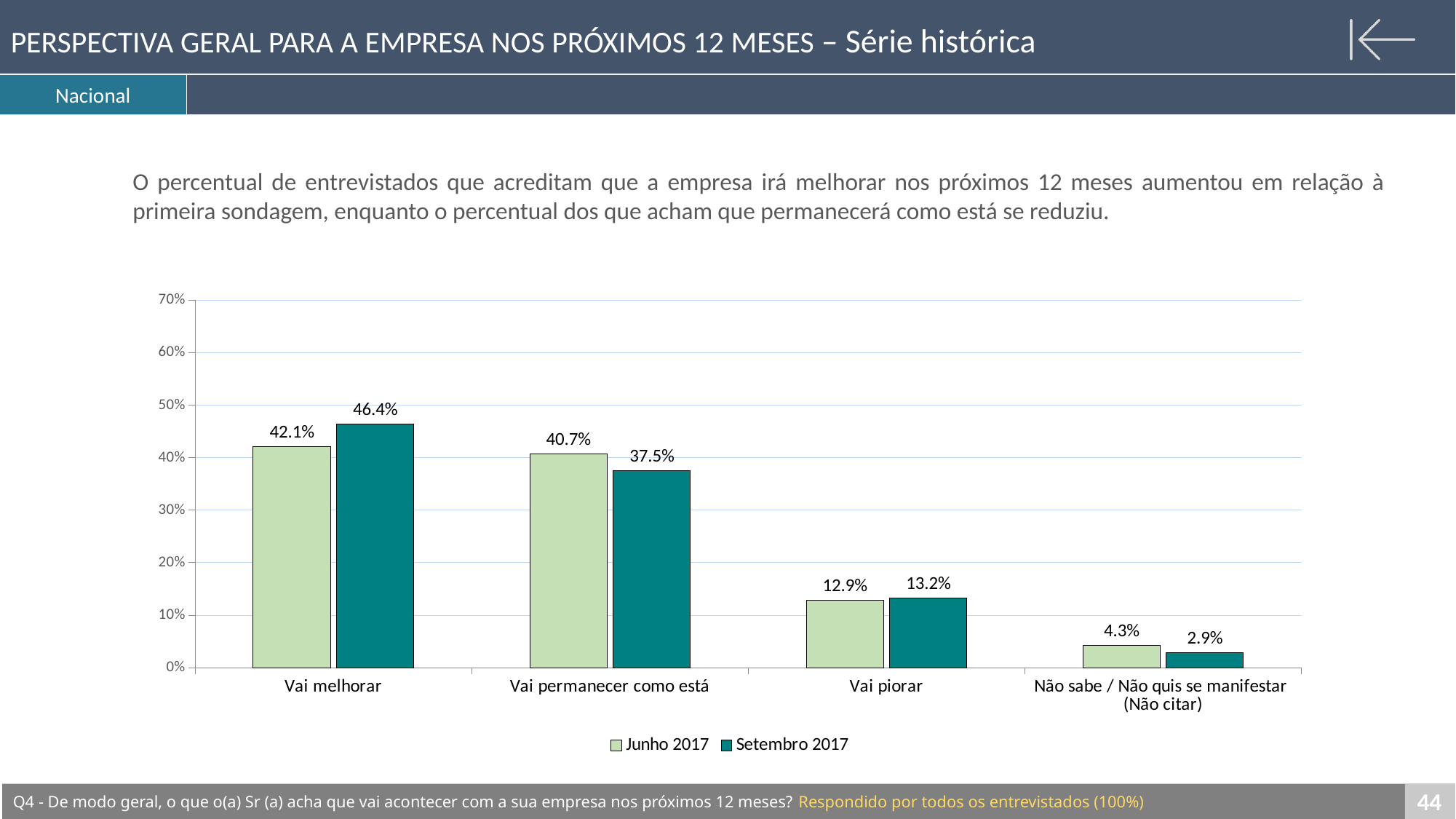
Which category has the lowest value in Junho 2017? Não sabe / Não quis se manifestar (Não citar) Which category has the highest value in Setembro 2017? Vai melhorar How many series does the legend list? 2 What is the value for 'Vai melhorar' in Setembro 2017? 46.4% Is the Junho 2017 value for 'Vai piorar' greater or less than 20%? less What kind of chart is shown on the slide? bar chart What is the value for 'Vai permanecer como está' in Junho 2017? 40.7% What is the difference between the Junho 2017 and Setembro 2017 values for 'Vai permanecer como está'? 3.2% What is the difference between the Setembro 2017 and Junho 2017 values for 'Vai melhorar'? 4.3% How many categories are shown on the x axis? 4 What is the value for 'Não sabe / Não quis se manifestar (Não citar)' in Setembro 2017? 2.9% For 'Vai permanecer como está', which series has the larger value, Junho 2017 or Setembro 2017? Junho 2017